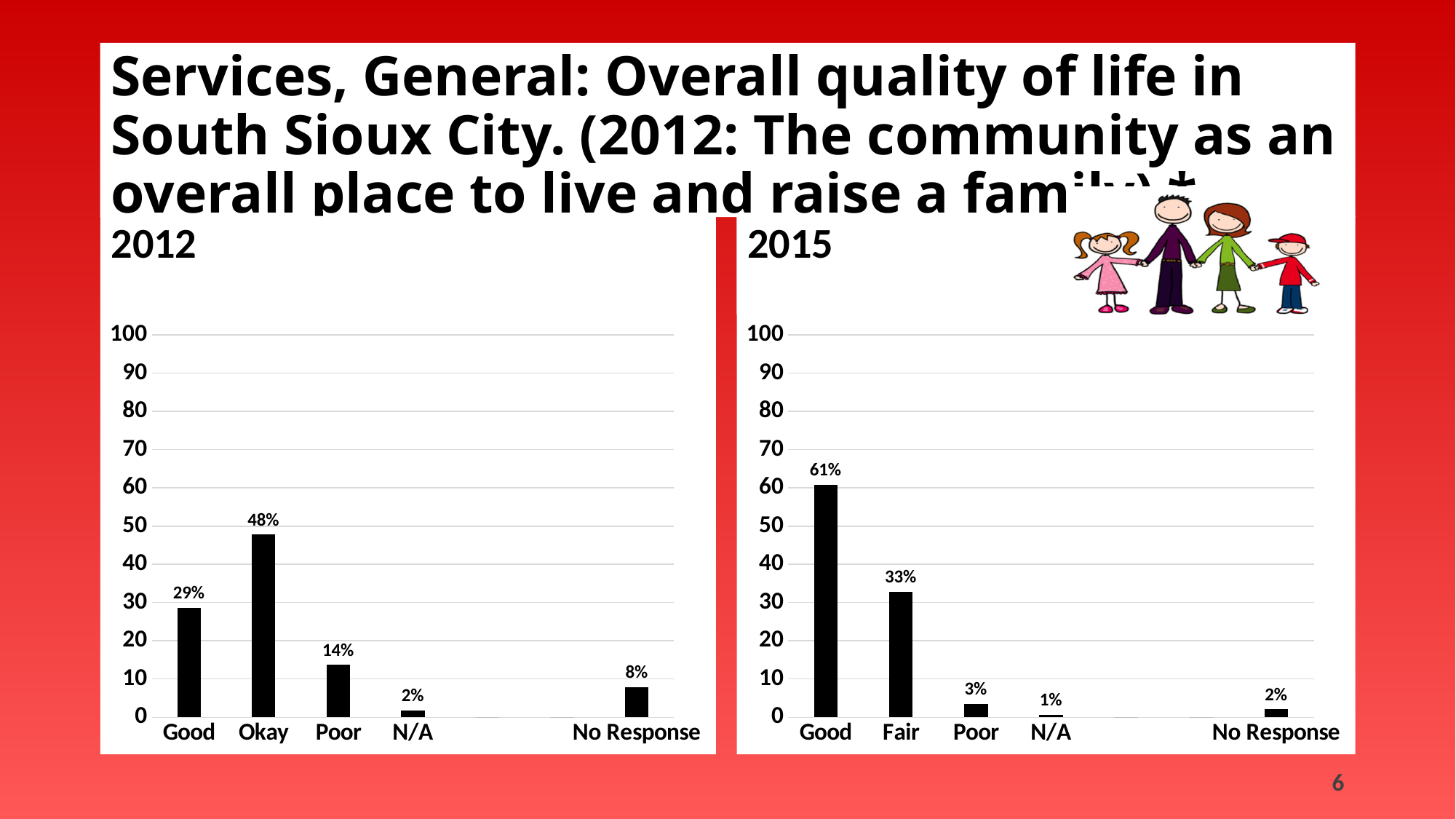
In the 2015 chart, what is the difference between Good and Fair? 28% In the 2015 chart, what is the value for Poor? 3% In the 2012 chart, what is the value for No Response? 8% In the 2012 chart, what is the value for Okay? 48% In the 2012 chart, which category has the highest value? Okay In the 2015 chart, what is the value for Good? 61% How many categories are shown on the x axis of the 2015 chart? 5 What kind of chart is the 2012 chart? bar chart In the 2012 chart, is the value for Okay greater or less than 40? greater In the 2012 chart, which is larger, Good or Poor? Good What is the difference between the Good value in the 2015 chart and the Good value in the 2012 chart? 32% In the 2015 chart, which category has the lowest value? N/A